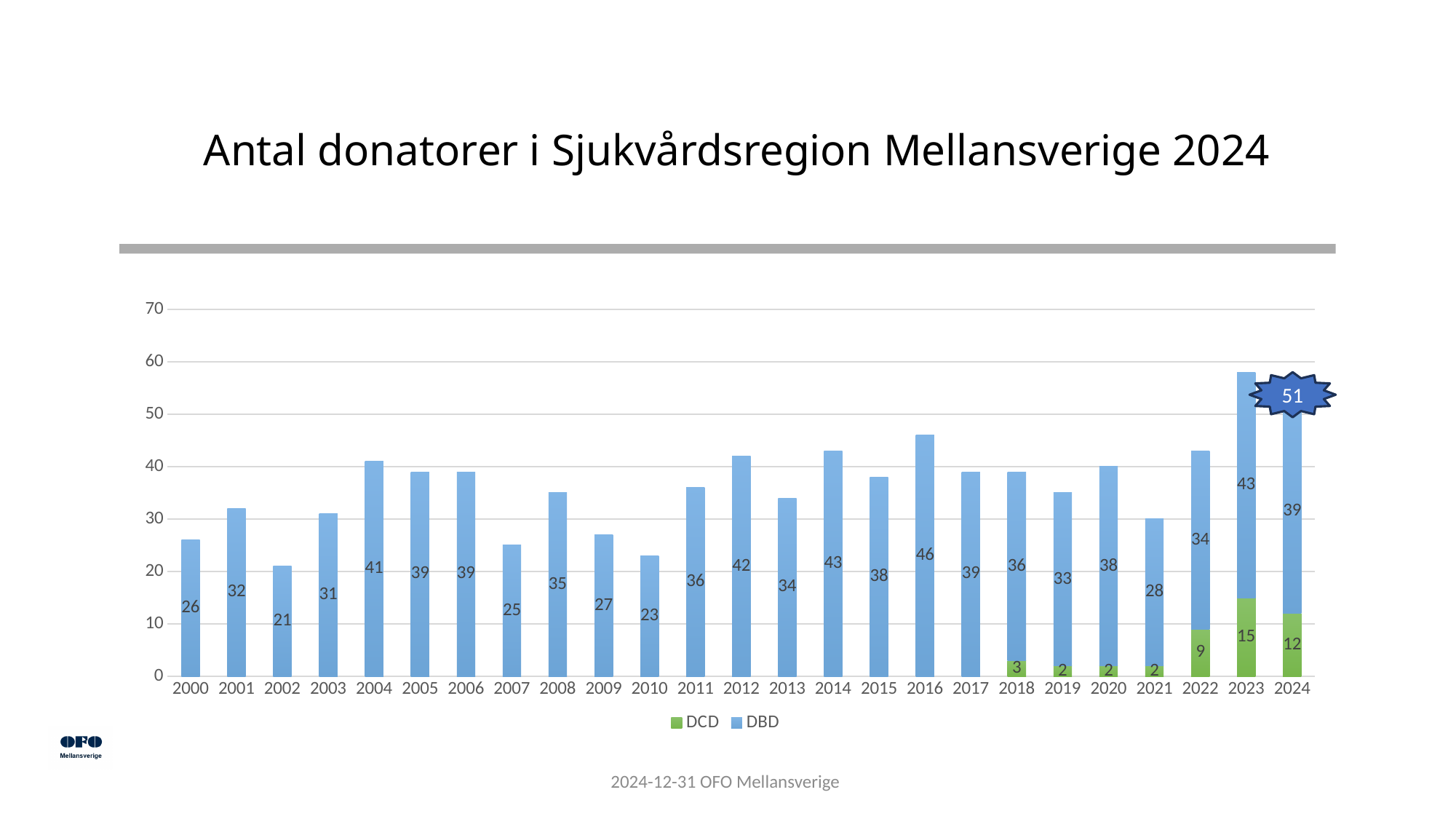
What is the total of the stacked bar for 2024? 51 What is the total of the stacked bar for 2023? 58 What is the DBD value for 2016? 46 How many series does the legend list? 2 Which year has the highest DCD value? 2023 What is the difference between the DBD values for 2004 and 2007? 16 Which is larger, the DBD value for 2012 or the DBD value for 2015? 2012 What kind of chart is shown on the slide? Stacked bar chart What is the DBD value for 2024? 39 What is the DCD value for 2023? 15 Which year has the lowest DBD value? 2002 How many years are shown on the x axis? 25